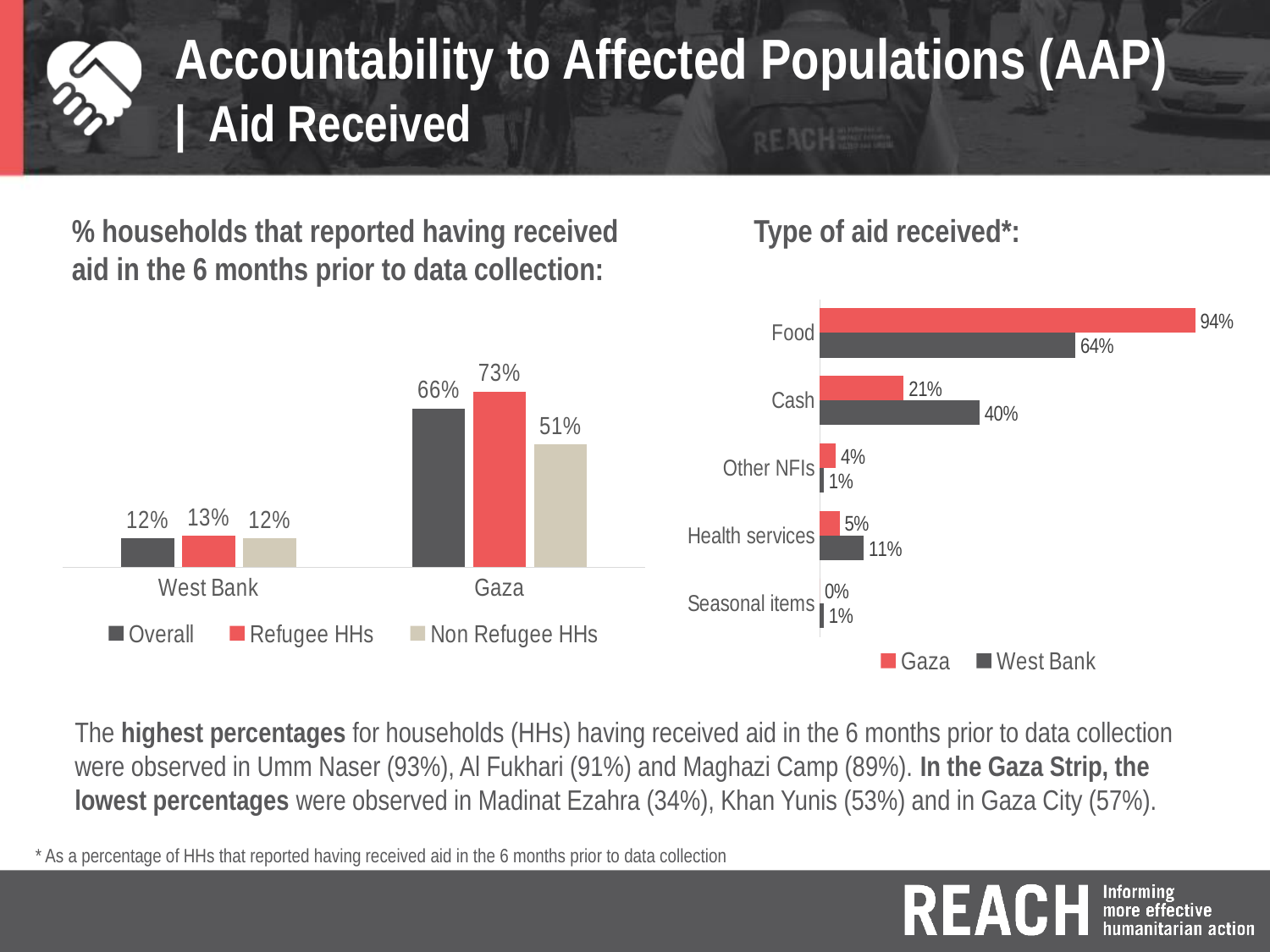
In the left chart (% households that reported having received aid), what is the value for Refugee HHs in Gaza? 73% In the right chart (Type of aid received), what is the value for Food in Gaza? 94% In the right chart (Type of aid received), which type of aid has the highest value for the West Bank? Food In the right chart (Type of aid received), is the value for Cash larger for Gaza or the West Bank? West Bank What kind of chart is the right chart (Type of aid received)? Bar chart In the right chart (Type of aid received), which type of aid has the lowest value for Gaza? Seasonal items In the right chart (Type of aid received), what is the value for Cash in the West Bank? 40% In the right chart (Type of aid received), how many types of aid are shown? 5 In the left chart (% households that reported having received aid), which series has the highest value for Gaza? Refugee HHs In the left chart (% households that reported having received aid), how many series does the legend list? 3 In the left chart (% households that reported having received aid), what is the difference between the Refugee HHs and Non Refugee HHs values for Gaza? 22% In the left chart (% households that reported having received aid), what is the Overall value for West Bank? 12%